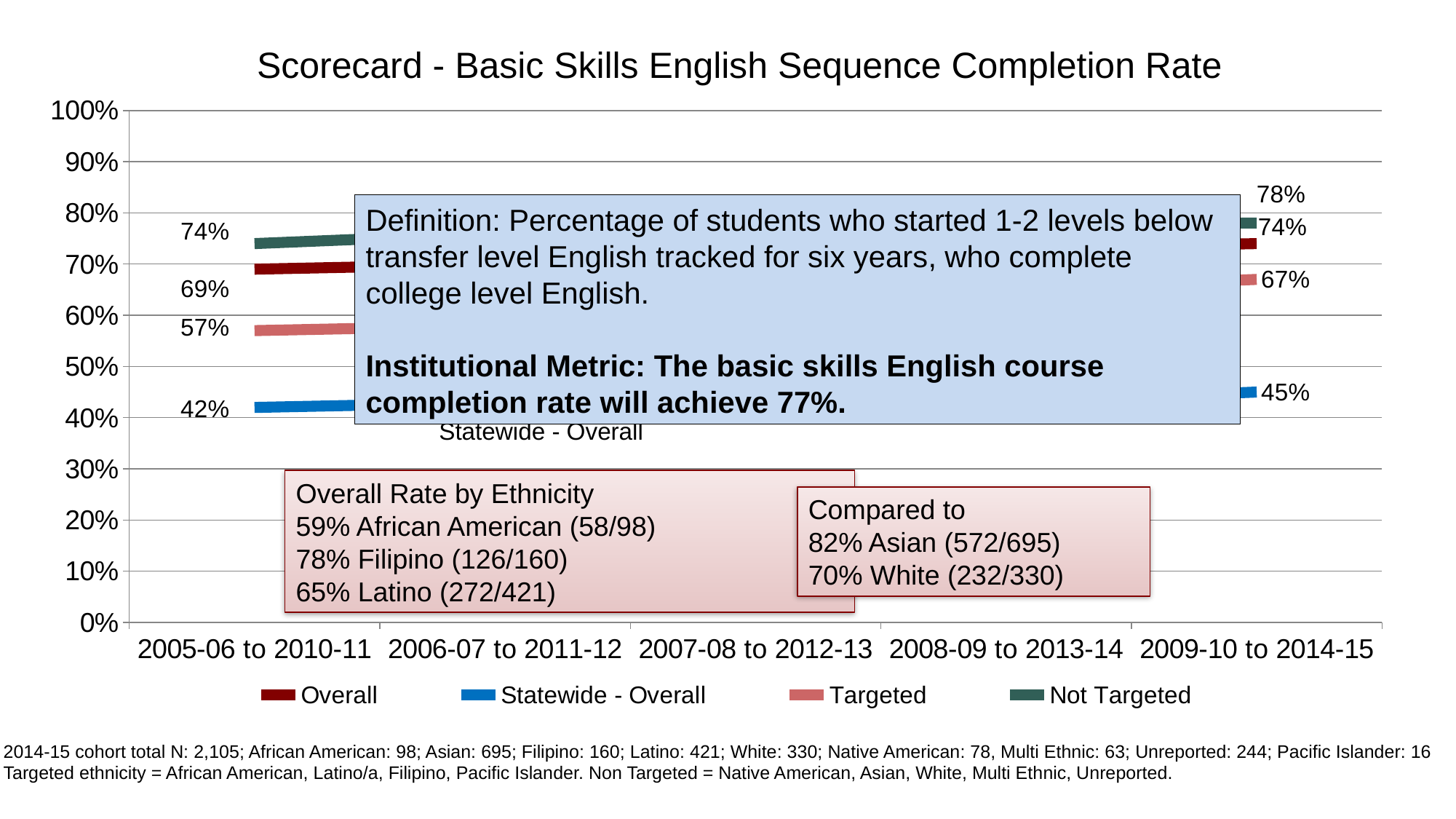
Which series has the highest value for the 2005-06 to 2010-11 cohort? Not Targeted Does the Overall completion rate rise or fall from the 2005-06 to 2010-11 cohort to the 2009-10 to 2014-15 cohort? rise What type of chart is shown on the slide? line chart What is the Not Targeted completion rate for the 2005-06 to 2010-11 cohort? 74% What is the title of the chart? Scorecard - Basic Skills English Sequence Completion Rate What is the difference between the Targeted rate for 2009-10 to 2014-15 and for 2005-06 to 2010-11? 10% How many series does the legend list? 4 Which series has the lowest value for the 2009-10 to 2014-15 cohort? Statewide - Overall What is the Overall completion rate for the 2009-10 to 2014-15 cohort? 74% What is the Targeted completion rate for the 2009-10 to 2014-15 cohort? 67% What is the Statewide - Overall completion rate for the 2005-06 to 2010-11 cohort? 42% How many cohort periods are shown on the x axis? 5